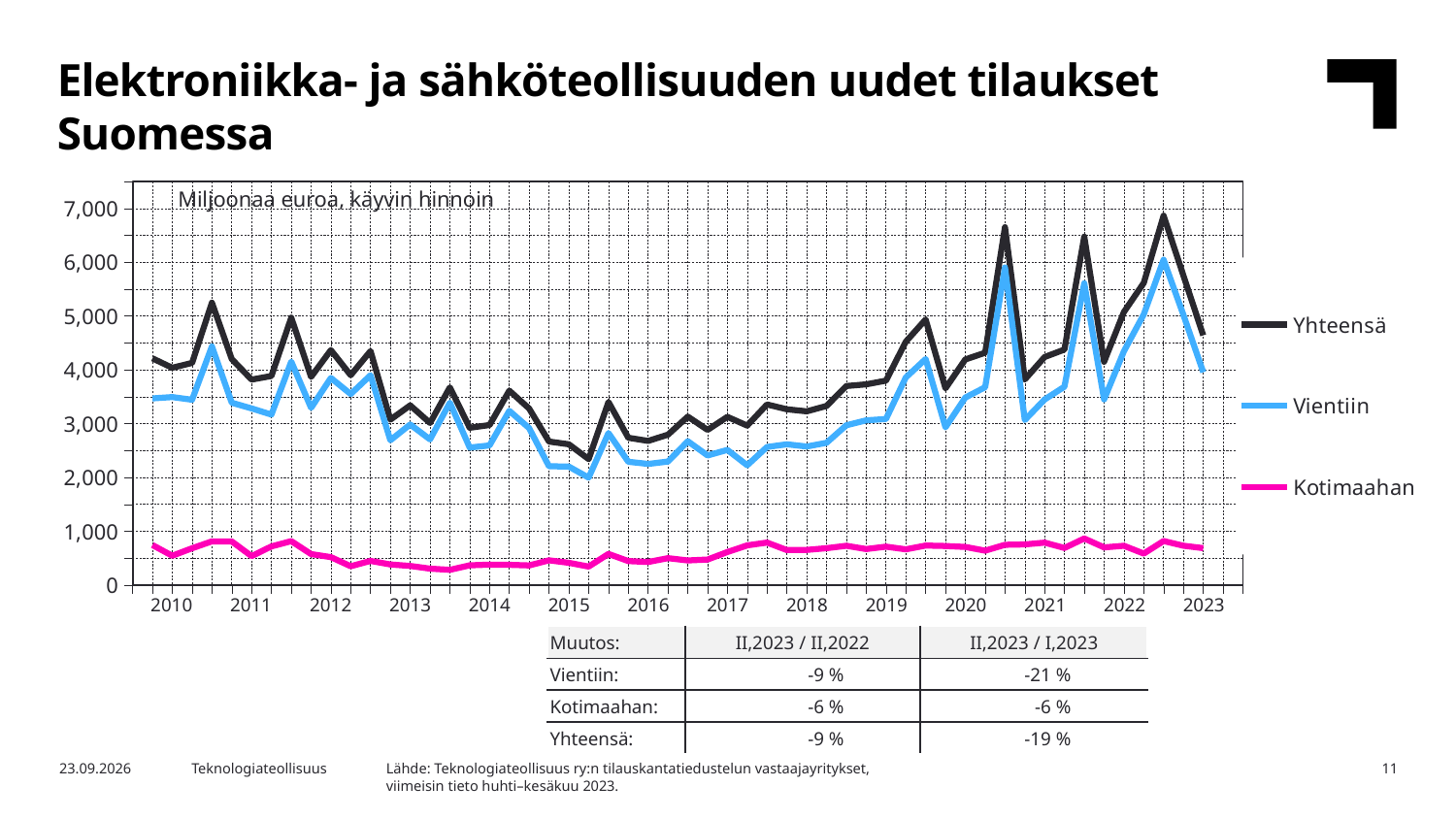
How many series does the chart legend list? 3 What are the three series named in the chart legend? Yhteensä, Vientiin, Kotimaahan How many year labels are shown on the x axis? 14 Does the Yhteensä series generally rise or fall between 2015 and 2019? rise Is the value for Kotimaahan in 2015 greater or less than 1,000? less Is the peak value for Yhteensä in 2022 greater or less than 6,000? greater What unit is stated in the chart's subtitle? Miljoonaa euroa, käyvin hinnoin In 2018, which is larger, Yhteensä or Vientiin? Yhteensä Which series has the highest values throughout the chart? Yhteensä Is the value for Vientiin in 2015 greater or less than 3,000? less Which series has the lowest values throughout the chart? Kotimaahan What kind of chart is shown on the slide? Line chart